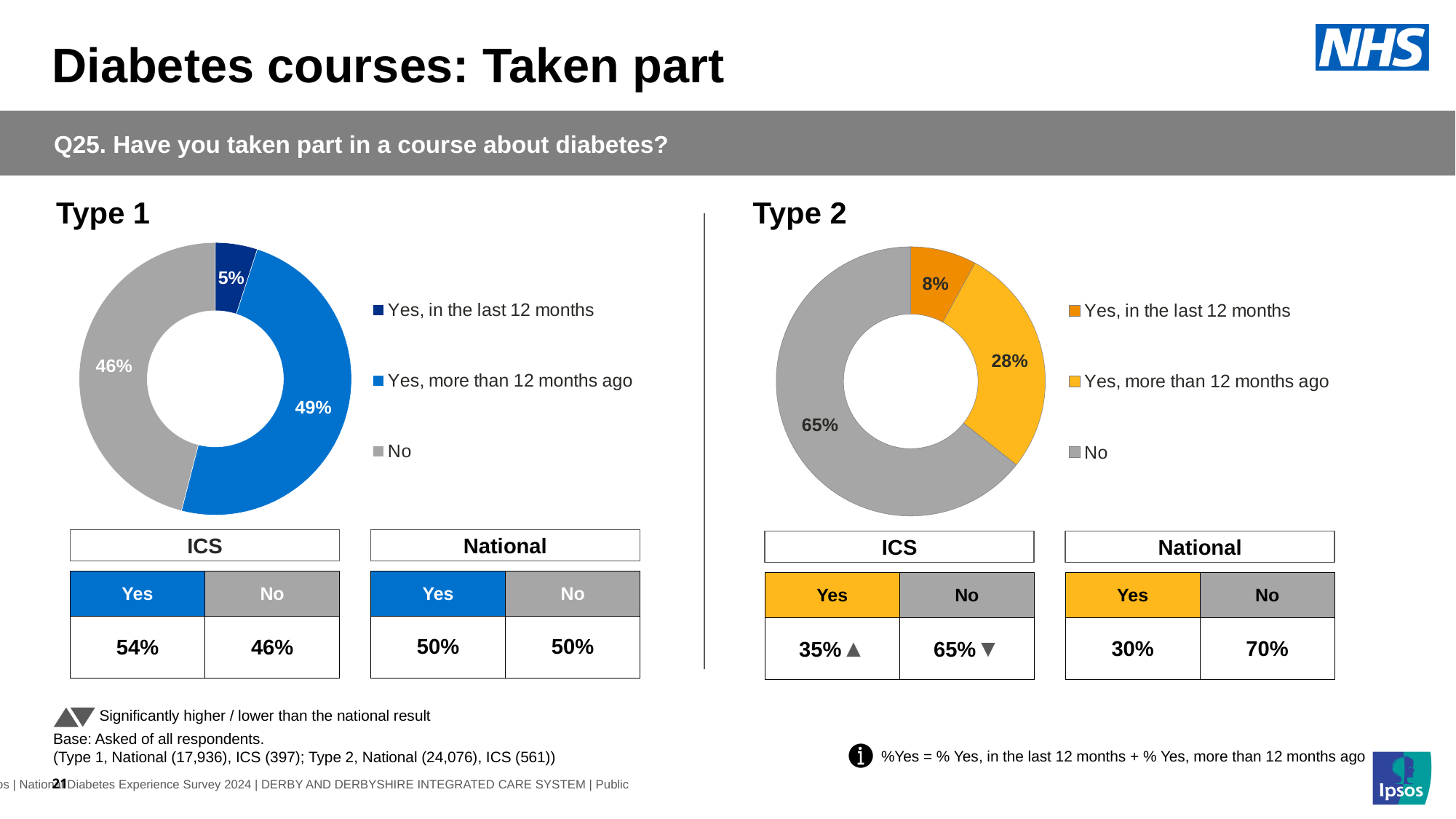
In the Type 2 chart, what percentage answered 'No'? 65% In the Type 1 chart, what is the combined share of the two 'Yes' responses? 54% In the Type 2 chart, which response has the smallest share? Yes, in the last 12 months In the Type 2 chart, what is the difference between the 'No' share and the 'Yes, more than 12 months ago' share? 37% In the Type 1 chart, what percentage answered 'Yes, in the last 12 months'? 5% In the Type 1 chart, what percentage answered 'No'? 46% How many categories does the Type 2 chart show? 3 In the Type 2 chart, what colour is the 'No' segment? Grey In the Type 1 chart, which is larger: 'Yes, more than 12 months ago' or 'No'? Yes, more than 12 months ago In the Type 1 chart, which response has the largest share? Yes, more than 12 months ago In the Type 2 chart, what percentage answered 'Yes, more than 12 months ago'? 28% What kind of chart is the Type 1 chart? Doughnut chart